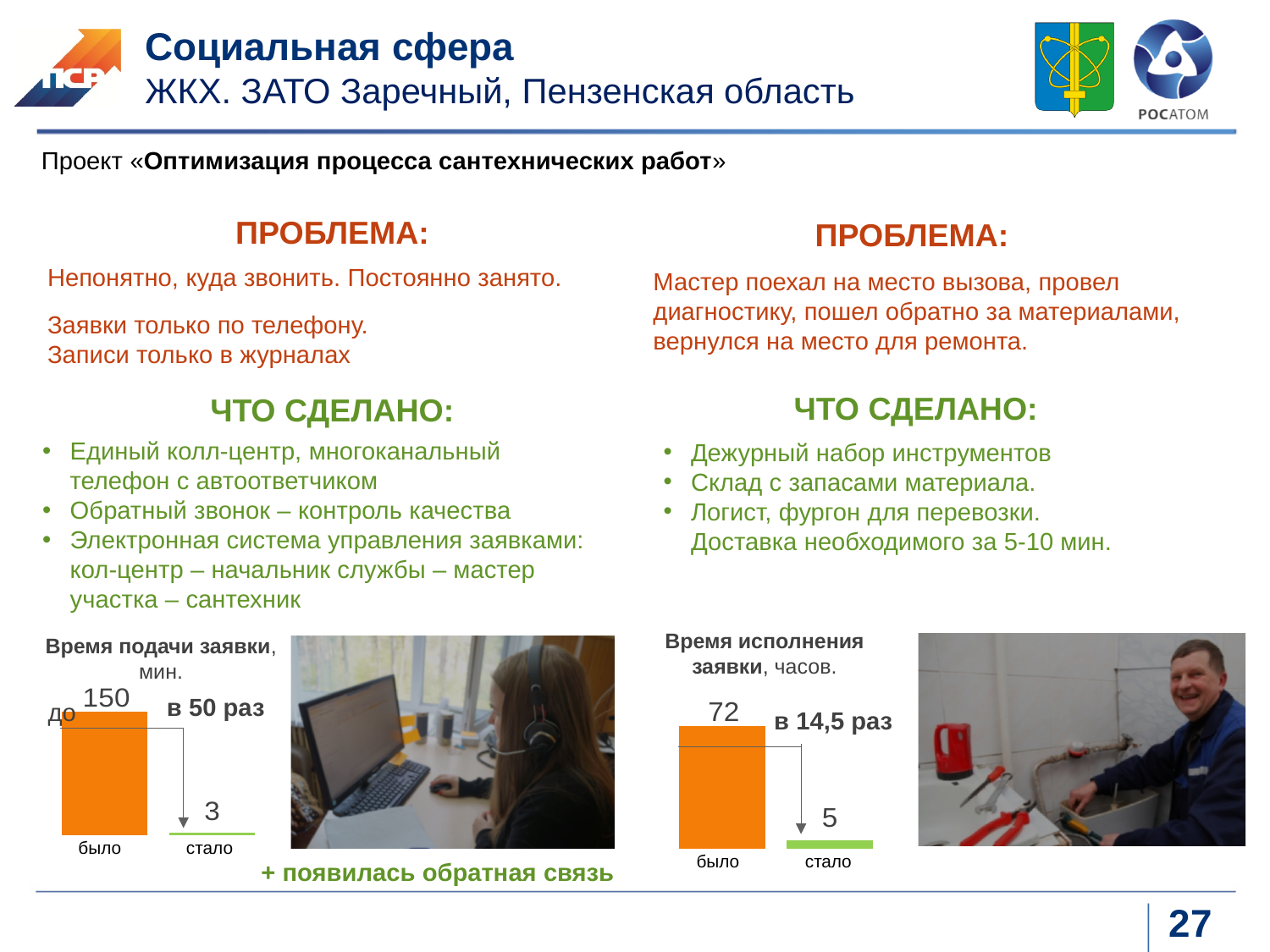
In the chart 'Время исполнения заявки, часов', what is the value for 'стало'? 5 What type of chart is 'Время исполнения заявки, часов'? bar chart In the chart 'Время подачи заявки, мин.', what is the value for 'стало'? 3 In the chart 'Время подачи заявки, мин.', which category has the higher value? было In the chart 'Время подачи заявки, мин.', what is the value for 'было'? 150 In the chart 'Время исполнения заявки, часов', is the value for 'было' larger or smaller than the value for 'стало'? larger In the chart 'Время исполнения заявки, часов', which category has the lowest value? стало In the chart 'Время подачи заявки, мин.', what is the difference between 'было' and 'стало'? 147 In the chart 'Время подачи заявки, мин.', by what factor does the annotation say the value decreased? в 50 раз In the chart 'Время исполнения заявки, часов', what is the value for 'было'? 72 In the chart 'Время исполнения заявки, часов', what is the difference between 'было' and 'стало'? 67 How many categories are shown in the chart 'Время подачи заявки, мин.'? 2